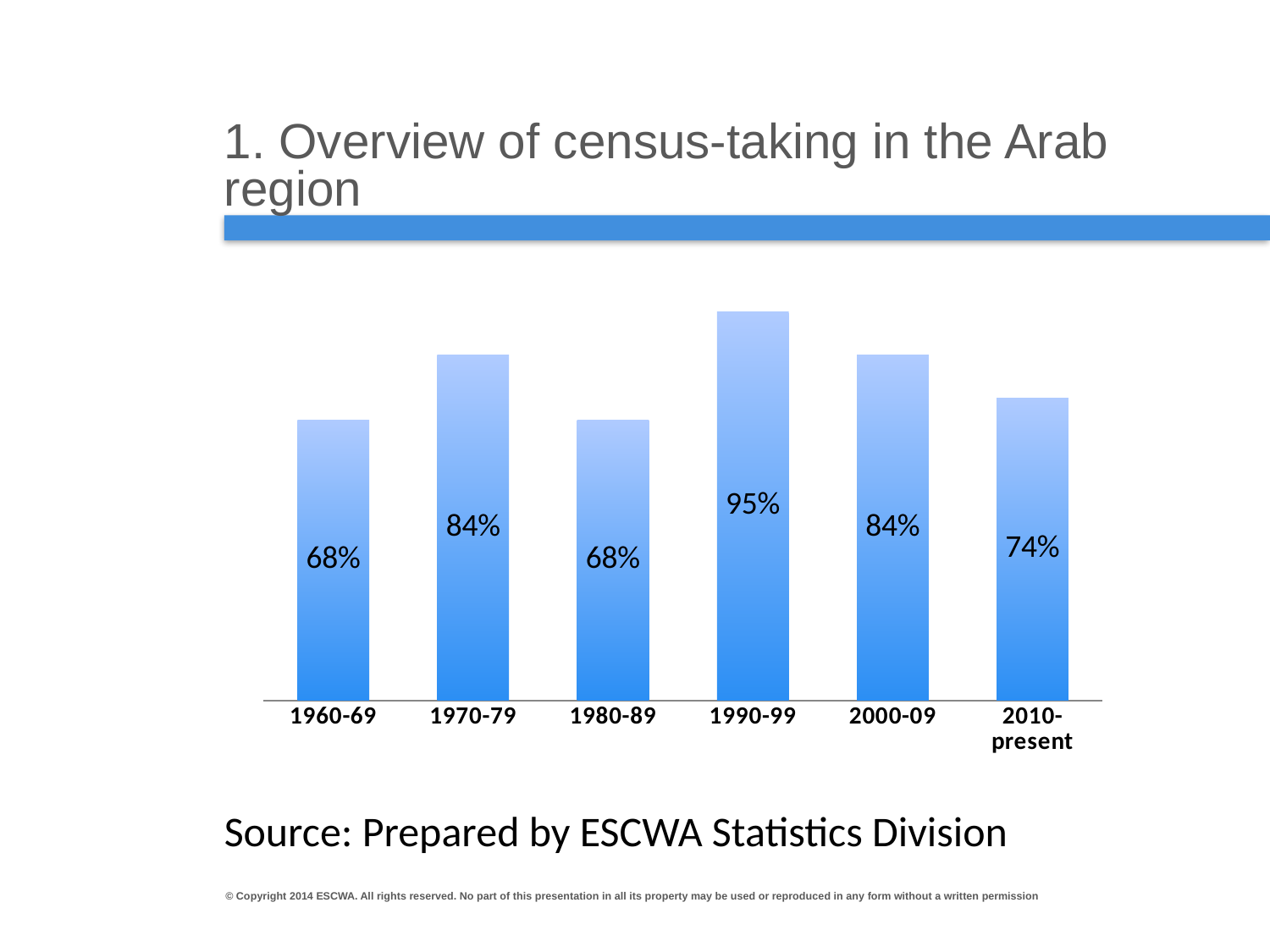
Which is larger, the value for 2000-09 or the value for 2010-present? 2000-09 What is the value for 2010-present? 74% Which period has the highest value? 1990-99 What is the difference between the values for 1990-99 and 2010-present? 21% What is the value for 1990-99? 95% What is the value for 1970-79? 84% What is the difference between the values for 1970-79 and 1980-89? 16% What is the value for 1960-69? 68% According to the slide, who prepared the chart? ESCWA Statistics Division What kind of chart is shown on the slide? bar chart How many periods are shown on the x axis? 6 Which two periods share the same value of 68%? 1960-69 and 1980-89